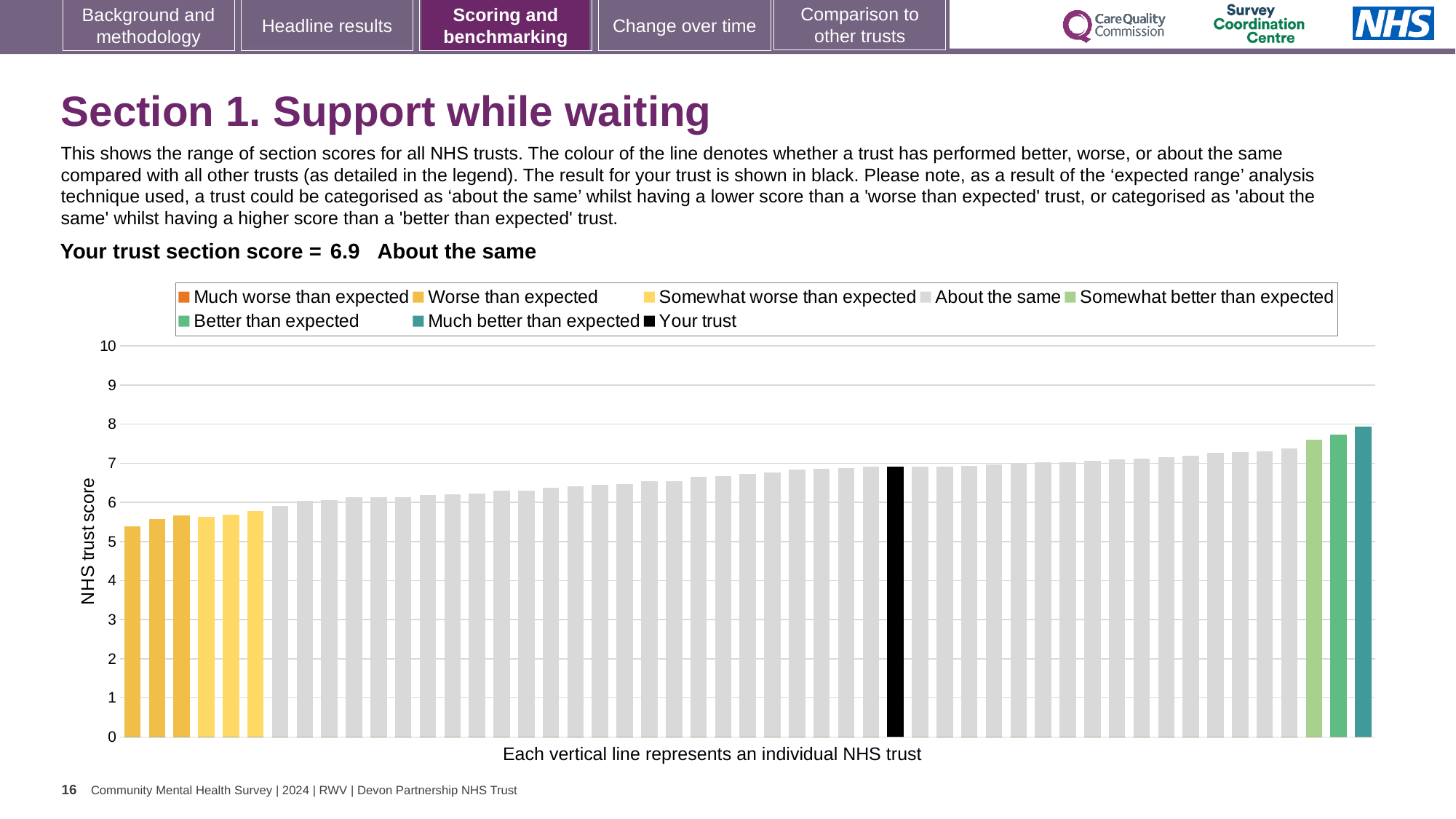
Is the value of the black bar (Your trust) greater or less than 6? greater What is the trust's section score shown on the slide? 6.9 What is the label on the y axis of the chart? NHS trust score What colour is used for the bar representing 'Your trust'? Black Is the value of the tallest bar greater or less than 8? less What is the highest value shown on the y axis? 10 How many entries does the chart legend list? 8 Do the bar values rise or fall from left to right along the x axis? Rise Is the trust's section score of 6.9 greater or less than 7? less What category is the trust's section score placed in? About the same What kind of chart is shown on the slide? Bar chart